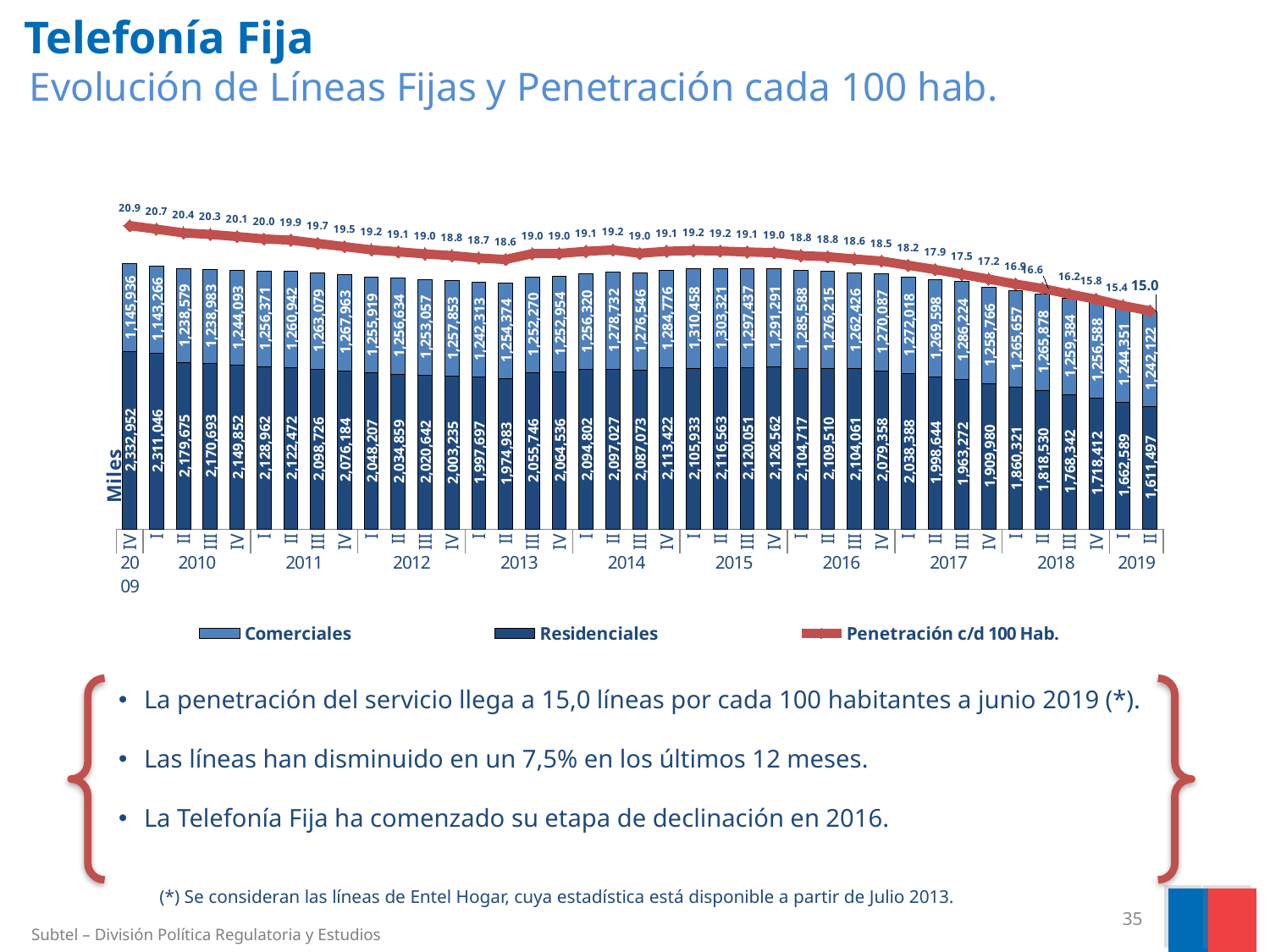
Does the Penetración c/d 100 Hab. line rise or fall from 2016 to 2019? fall Which is larger, the Residenciales value for I 2015 or for I 2018? I 2015 In which quarter is the Comerciales value highest? I 2015 In which quarter is the Residenciales value lowest? II 2019 What is the value of Comerciales for IV 2009? 1,145,936 What is the difference between the Residenciales value for IV 2009 and for II 2019? 721,455 What is the Penetración c/d 100 Hab. value for IV 2009? 20.9 What is the value of Residenciales for II 2019? 1,611,497 How many series does the legend list? 3 What is the total of the stacked bar for II 2019? 2,853,619 How many quarters (bars) are plotted in the chart? 39 What is the Penetración c/d 100 Hab. value for II 2019? 15.0